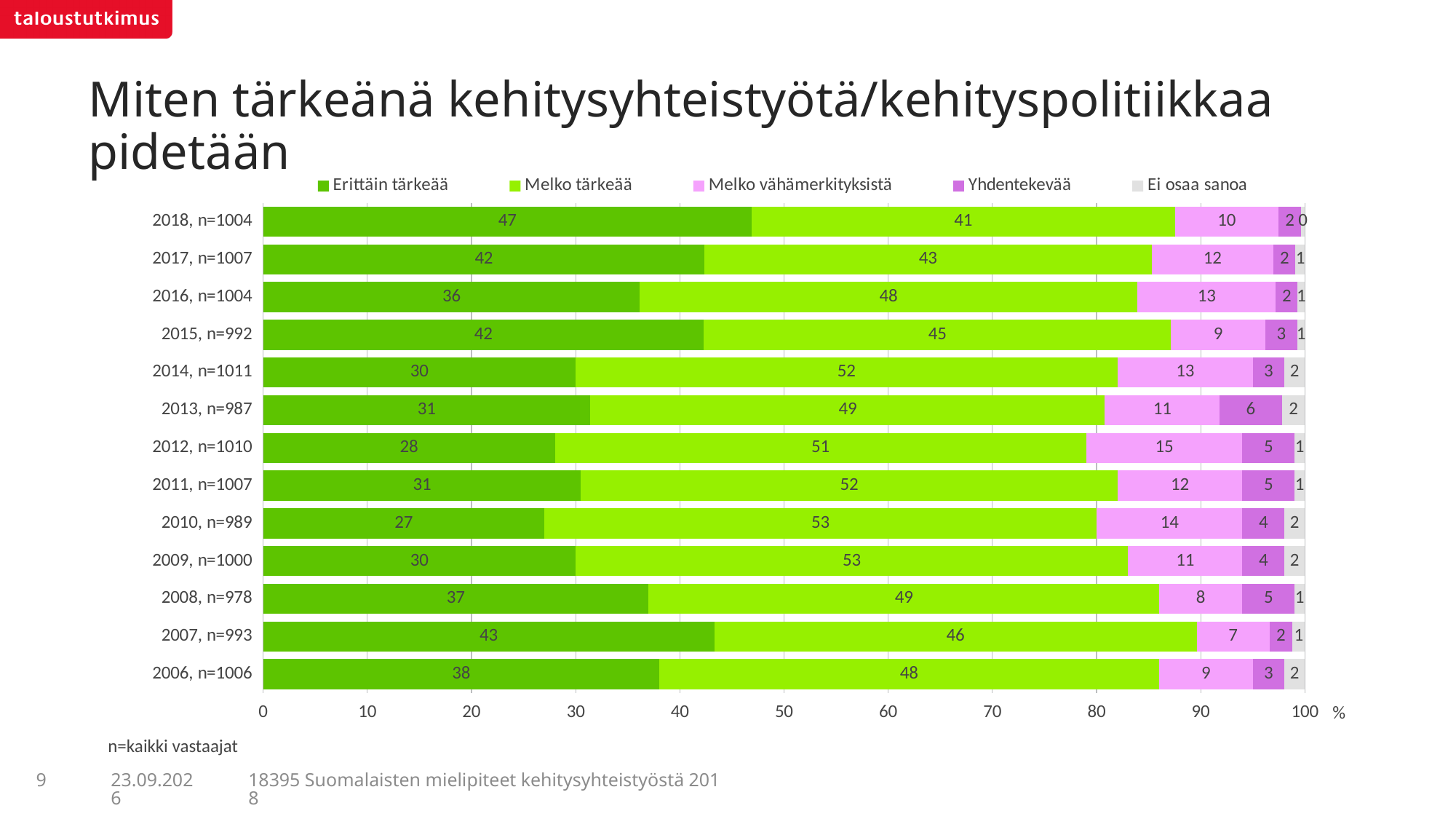
What kind of chart is shown on the slide? stacked bar chart Which is larger: the "Melko tärkeää" value for 2016, n=1004 or for 2018, n=1004? 2016, n=1004 What is the value of "Melko vähämerkityksistä" for 2012, n=1010? 15 How many series does the legend list? 5 What is the value of "Erittäin tärkeää" for 2018, n=1004? 47 Which year has the highest value for "Yhdentekevää"? 2013, n=987 What is the total of the stacked bar for 2013, n=987? 99 Which year has the highest value for "Erittäin tärkeää"? 2018, n=1004 Which year has the lowest value for "Erittäin tärkeää"? 2010, n=989 How many year categories are plotted on the chart? 13 What is the value of "Melko tärkeää" for 2014, n=1011? 52 What is the difference between the "Erittäin tärkeää" values for 2018, n=1004 and 2006, n=1006? 9